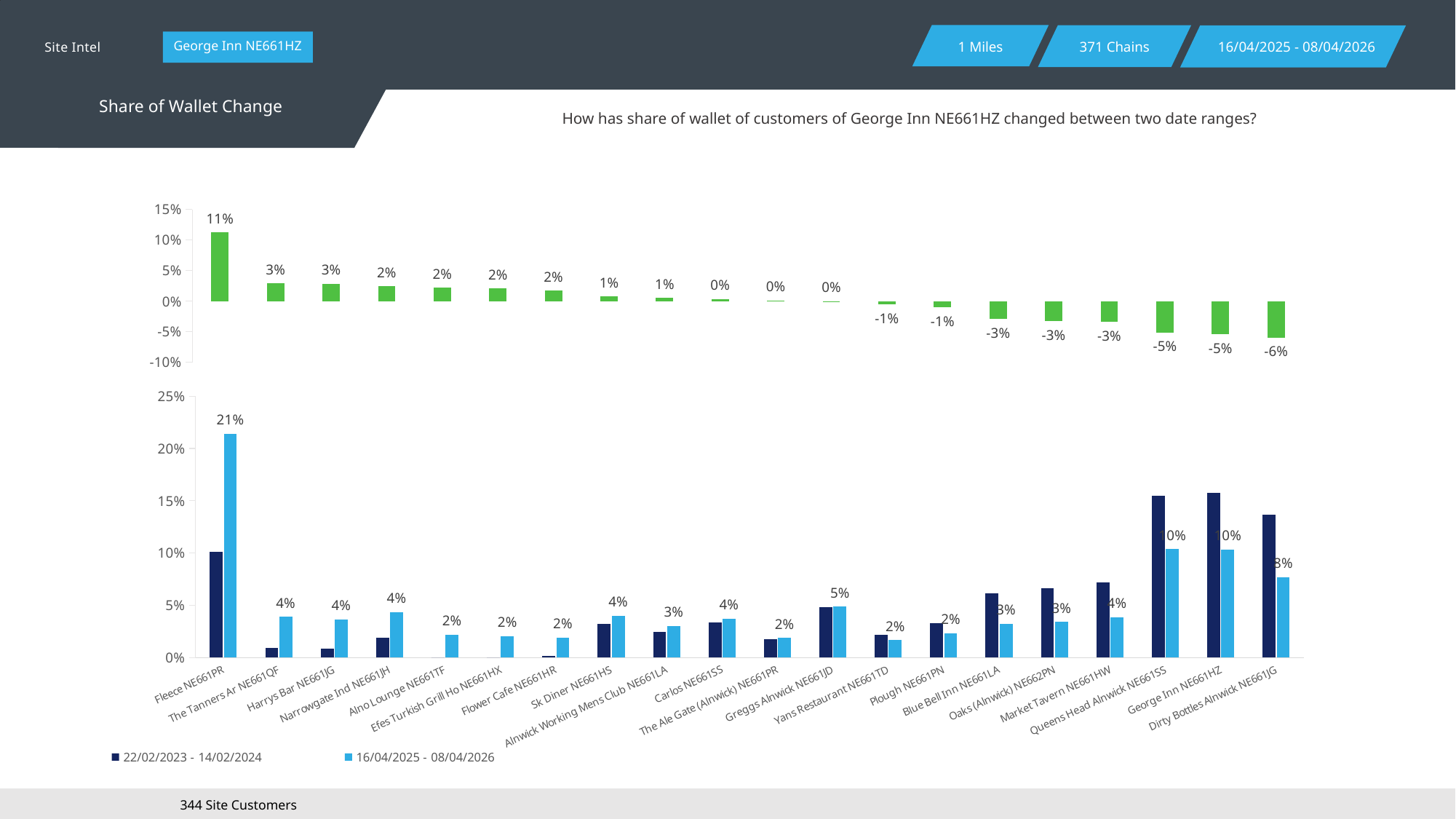
In the top chart, what is the share of wallet change for Fleece NE661PR? 11% In the top chart, what is the share of wallet change for Dirty Bottles Alnwick NE661JG? -6% In the top chart, which venue has the highest share of wallet change? Fleece NE661PR In the top chart, is the change for Blue Bell Inn NE661LA larger or smaller than the change for Sk Diner NE661HS? smaller In the top chart, what is the difference between the change for Fleece NE661PR and the change for The Tanners Ar NE661QF? 8 percentage points In the bottom chart, is the 22/02/2023 - 14/02/2024 value for George Inn NE661HZ greater or less than 15%? greater In the bottom chart, what is the share of wallet for Greggs Alnwick NE661JD in the 16/04/2025 - 08/04/2026 period? 5% In the bottom chart, what is the share of wallet for Fleece NE661PR in the 16/04/2025 - 08/04/2026 period? 21% In the top chart, which venue has the lowest share of wallet change? Dirty Bottles Alnwick NE661JG How many venues are shown on the x axis of the bottom chart? 20 How many series does the legend of the bottom chart list? 2 In the bottom chart, is the 22/02/2023 - 14/02/2024 value for Dirty Bottles Alnwick NE661JG greater or less than 10%? greater